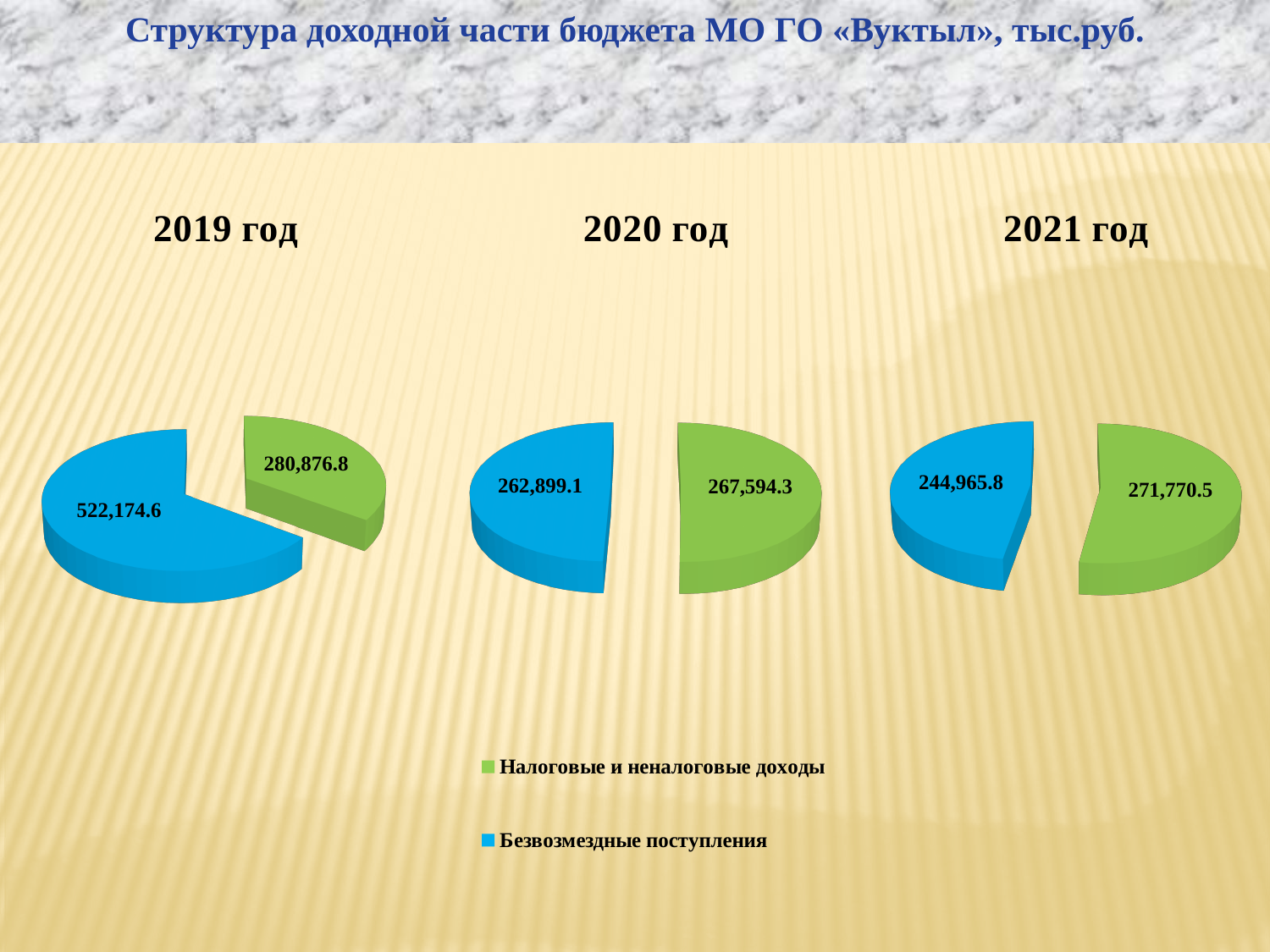
How many categories does the legend list? 2 In the 2019 год pie chart, what is the value for Налоговые и неналоговые доходы? 280,876.8 In the 2021 год pie chart, what is the value for Налоговые и неналоговые доходы? 271,770.5 In the 2021 год pie chart, what is the difference between Налоговые и неналоговые доходы and Безвозмездные поступления? 26,804.7 What type of chart is used for each year on the slide? Pie chart In the 2021 год pie chart, which category is the smallest? Безвозмездные поступления In the 2020 год pie chart, what is the value for Налоговые и неналоговые доходы? 267,594.3 In the 2019 год pie chart, what is the value for Безвозмездные поступления? 522,174.6 In the 2020 год pie chart, which is larger: Налоговые и неналоговые доходы or Безвозмездные поступления? Налоговые и неналоговые доходы In the 2019 год pie chart, what is the difference between Безвозмездные поступления and Налоговые и неналоговые доходы? 241,297.8 In the 2021 год pie chart, what is the value for Безвозмездные поступления? 244,965.8 In the 2019 год pie chart, which category is the largest? Безвозмездные поступления